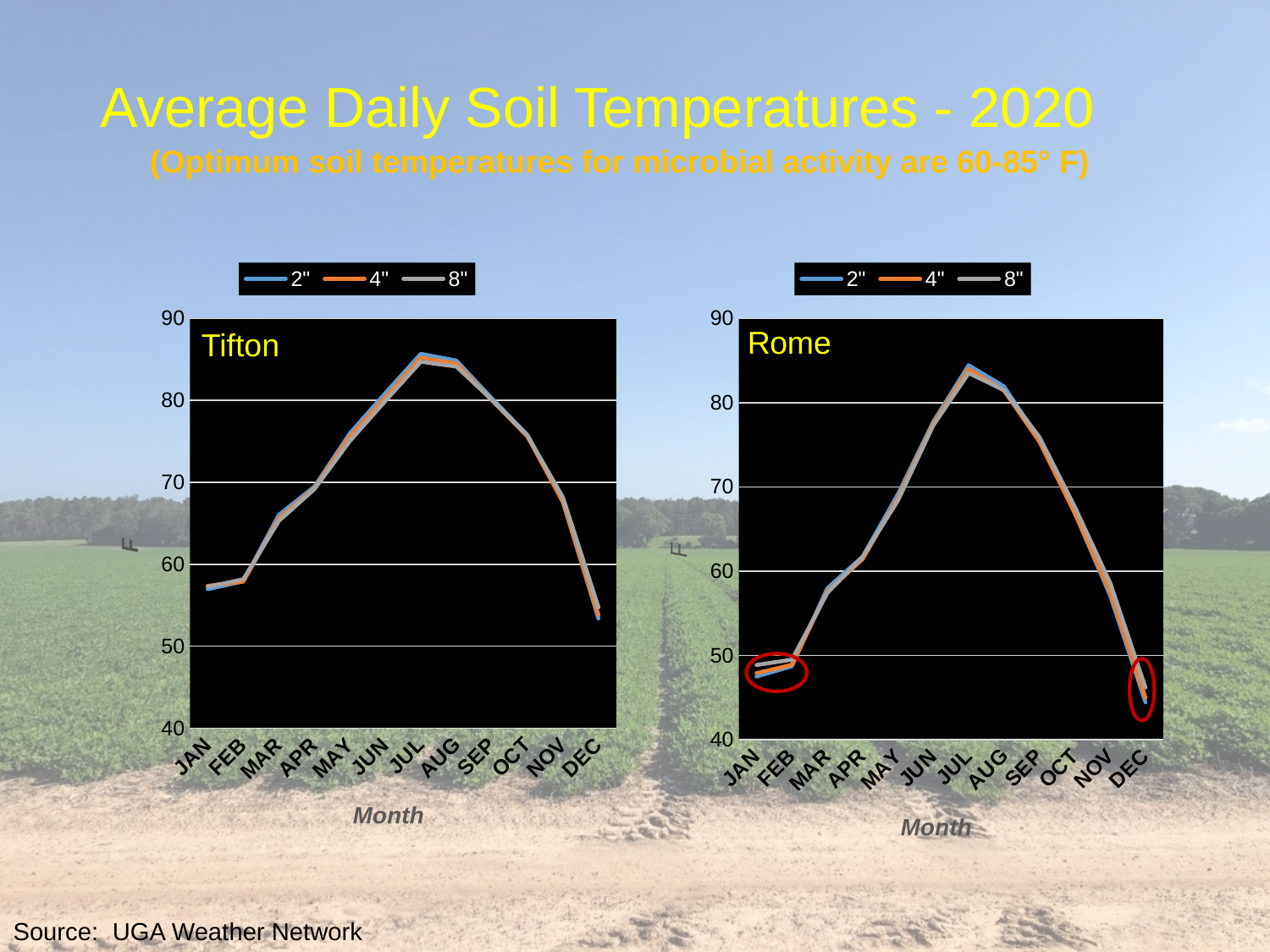
In the Rome chart, is the soil temperature for JAN greater or less than 50? less What kind of chart is the Tifton chart? line chart In the Rome chart, is the soil temperature for AUG greater or less than 80? greater Which chart shows the higher soil temperature in JAN, Tifton or Rome? Tifton How many months are plotted along the x axis of the Tifton chart? 12 What are the three series listed in the legend of the Tifton chart? 2", 4", 8" How many series does the legend of the Rome chart list? 3 In the Tifton chart, which month has the highest soil temperature? JUL In the Tifton chart, is the soil temperature for JUL greater or less than 80? greater In the Rome chart, which month has the highest soil temperature? JUL In the Rome chart, do the soil temperatures rise or fall from JUL to DEC? fall